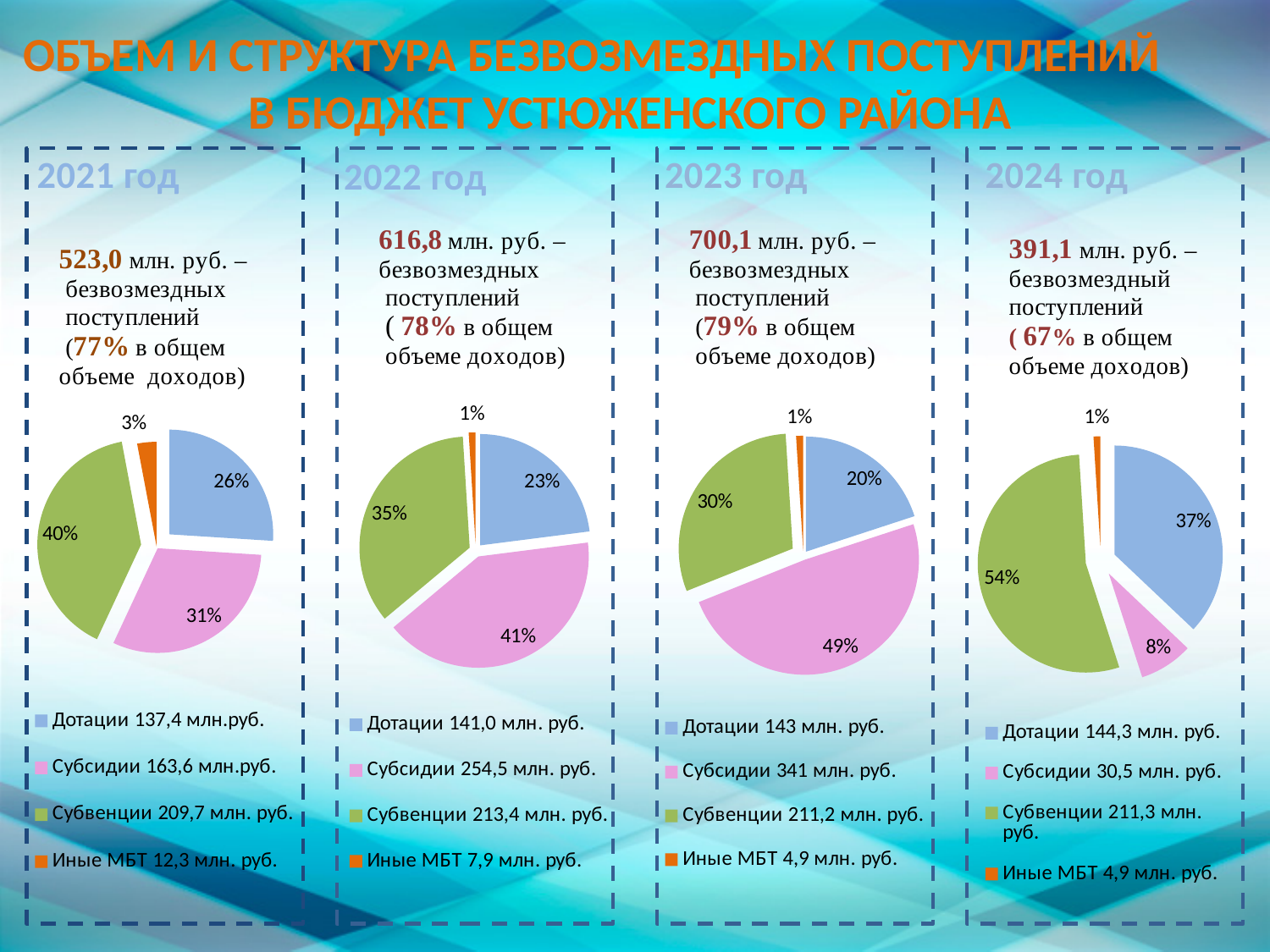
In the 2022 год pie chart, which slice is larger: Субсидии or Субвенции? Субсидии In the 2024 год pie chart, which category has the largest slice? Субвенции How many entries does the legend of the 2021 год chart list? 4 According to the legend of the 2023 год chart, what is the value for Субсидии? 341 млн. руб. What type of chart is used for the 2022 год data? Pie chart In the 2024 год pie chart, what share does Субсидии have? 8% In the 2021 год pie chart, what share does Субвенции have? 40% In the 2023 год pie chart, which category has the smallest slice? Иные МБТ In the 2023 год pie chart, what share does Дотации have? 20% How many slices does the 2023 год pie chart have? 4 In the 2021 год pie chart, what is the difference in percentage points between the Субвенции slice and the Дотации slice? 14